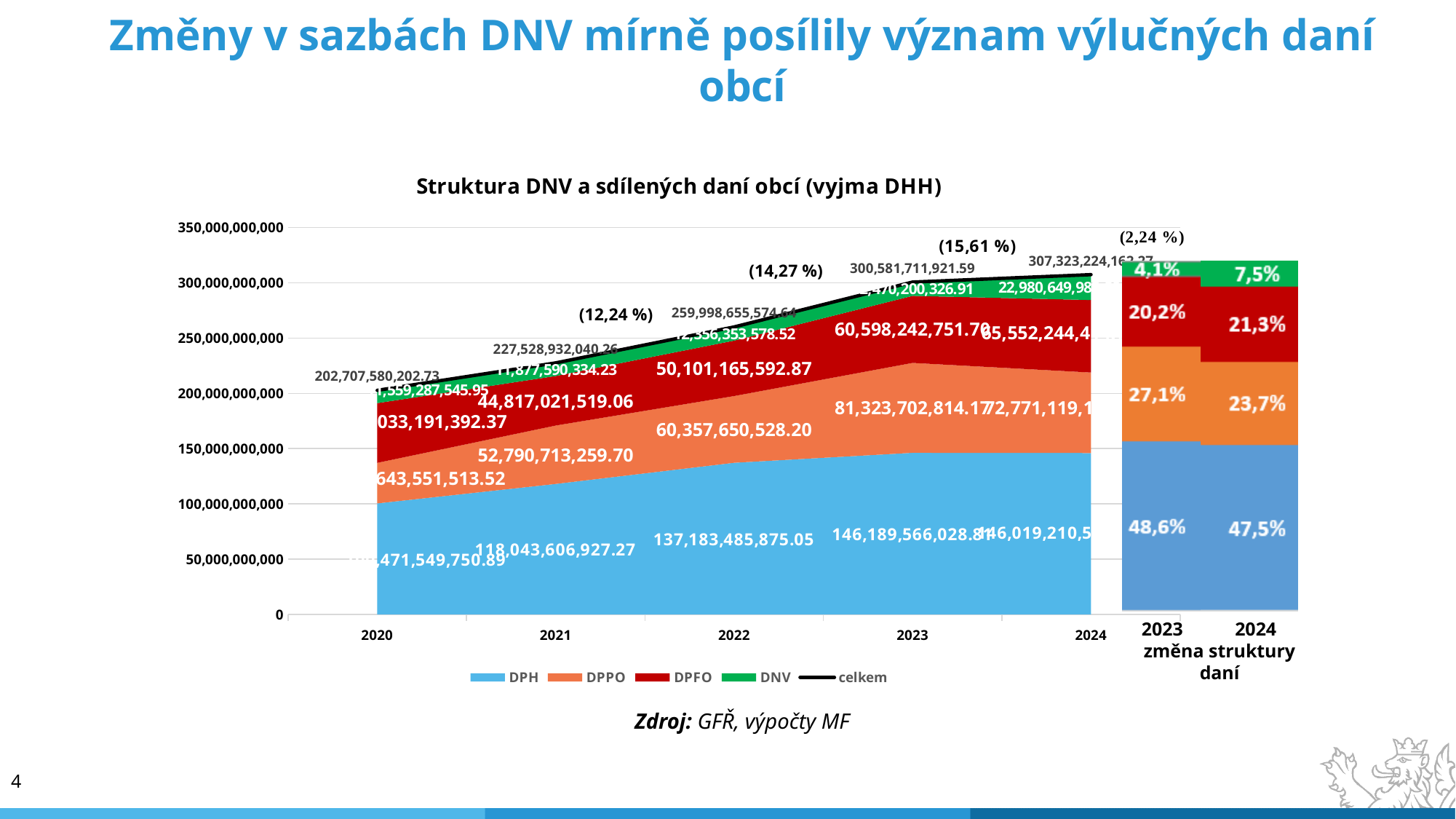
In the main chart 'Struktura DNV a sdílených daní obcí (vyjma DHH)', what is the value of 'celkem' for 2023? 300,581,711,921.59 In the main chart 'Struktura DNV a sdílených daní obcí (vyjma DHH)', how many series does the legend list? 5 In the main chart 'Struktura DNV a sdílených daní obcí (vyjma DHH)', what is the DPFO value for 2022? 50,101,165,592.87 In the stacked bar chart on the right ('změna struktury daní'), what is the DPH share for 2024? 47,5% In the main chart 'Struktura DNV a sdílených daní obcí (vyjma DHH)', what is the DPPO value for 2021? 52,790,713,259.70 In the main chart 'Struktura DNV a sdílených daní obcí (vyjma DHH)', what is the DPH value for 2022? 137,183,485,875.05 In the main chart 'Struktura DNV a sdílených daní obcí (vyjma DHH)', does the 'celkem' line rise or fall from 2020 to 2024? Rises In the stacked bar chart on the right ('změna struktury daní'), by how many percentage points did the DNV share increase from 2023 (4,1%) to 2024 (7,5%)? 3,4% In the main chart 'Struktura DNV a sdílených daní obcí (vyjma DHH)', how many years are shown on the x axis? 5 In the main chart 'Struktura DNV a sdílených daní obcí (vyjma DHH)', what is the DNV value for 2021? 11,877,590,334.23 In the stacked bar chart on the right ('změna struktury daní'), is the DPH share larger in 2023 or in 2024? 2023 What kind of chart is the main chart titled 'Struktura DNV a sdílených daní obcí (vyjma DHH)'? Stacked area chart